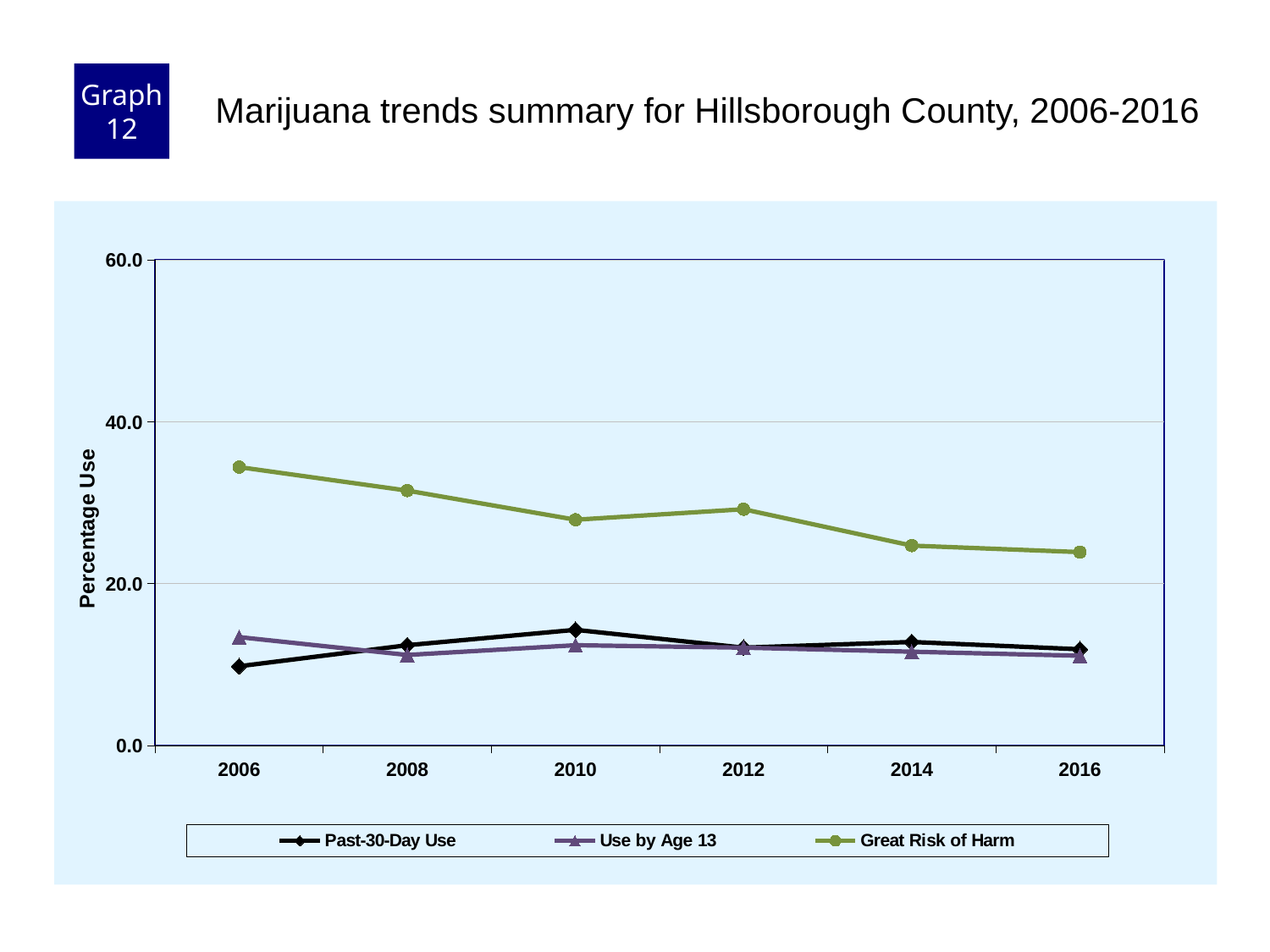
How many series does the legend list? 3 What is the label on the y axis? Percentage Use Is the Great Risk of Harm value for 2006 greater or less than 40.0? less Does the Great Risk of Harm line generally rise or fall from 2006 to 2016? fall In 2006, which is larger: Use by Age 13 or Past-30-Day Use? Use by Age 13 What kind of chart is shown on the slide? line chart In which year is the Past-30-Day Use value lowest? 2006 Is the Great Risk of Harm value for 2016 greater or less than 20.0? greater In which year is the Past-30-Day Use value highest? 2010 Is the Past-30-Day Use value for 2010 greater or less than 20.0? less How many years are plotted along the x axis? 6 In which year is the Great Risk of Harm value highest? 2006